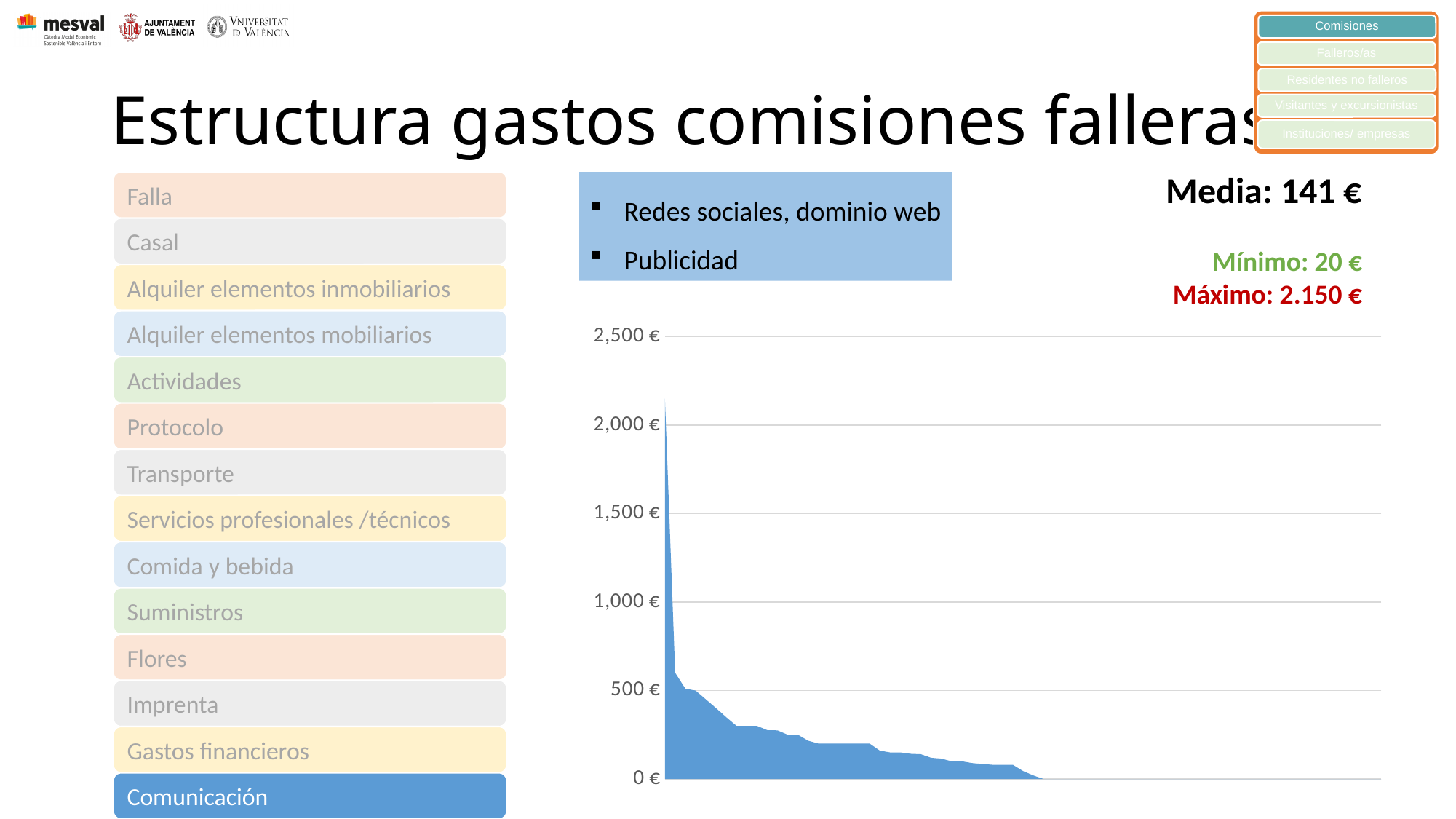
What is the average (Media) stated on the slide for the communication expenses? 141 € Is the highest value plotted in the chart greater or less than 2,000 €? greater Are the values at the right-hand end of the chart greater or less than 500 €? less What is the highest tick value shown on the chart's vertical axis? 2,500 € Which expense category from the left-hand list is highlighted for this chart? Comunicación What kind of chart is shown on the slide? area chart Do the values in the chart rise or fall from left to right along the x axis? fall What is the maximum value (Máximo) stated on the slide for the communication expenses? 2.150 € Is the highest value plotted in the chart greater or less than 2,500 €? less What is the minimum value (Mínimo) stated on the slide for the communication expenses? 20 €